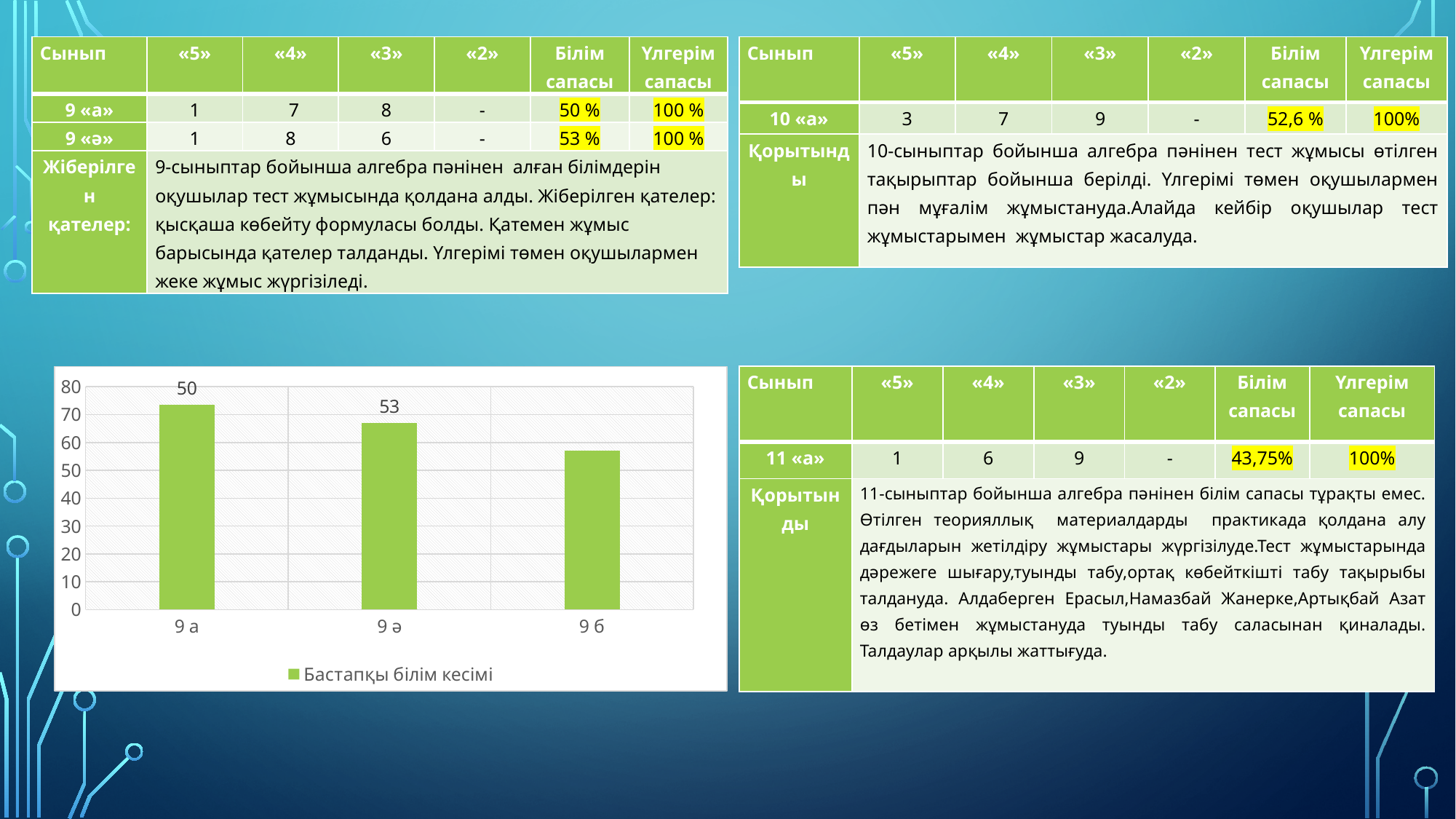
Is the value for 9 б in the bar chart greater or less than 40? greater How many categories are shown on the x axis of the bar chart? 3 What is the highest value shown on the y axis of the chart? 80 What kind of chart is shown on the slide? bar chart Is the value for 9 б in the bar chart greater or less than 80? less What is the name of the series in the chart legend? Бастапқы білім кесімі What is the difference between the labelled values for 9 ә and 9 а in the bar chart? 3 What is the value shown for 9 а in the bar chart? 50 What is the value shown for 9 ә in the bar chart? 53 How many series does the legend of the chart list? 1